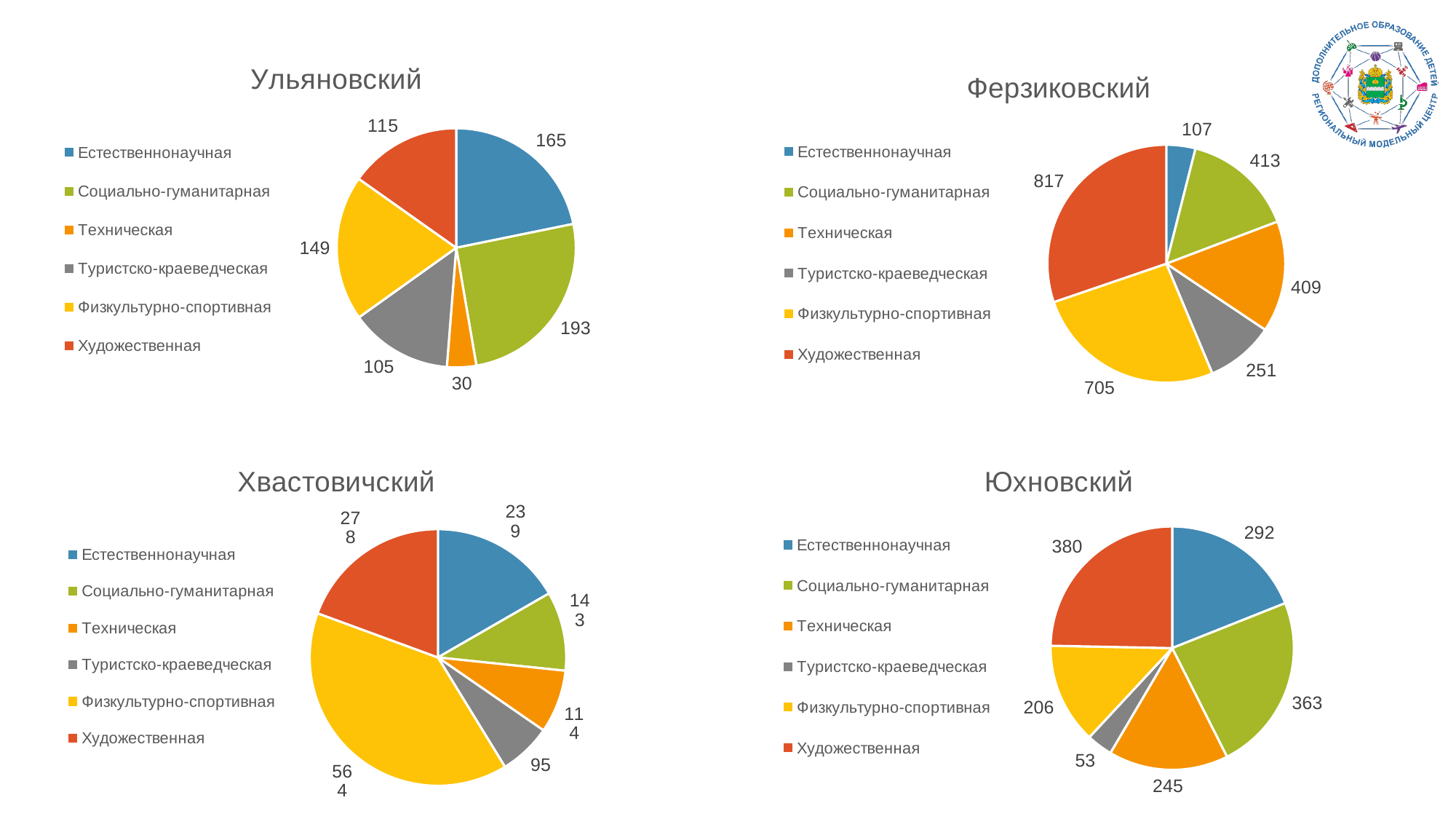
In the Ферзиковский chart, what is the value for Физкультурно-спортивная? 705 What type of chart is used for Ульяновский? Pie chart In the Юхновский chart, what is the value for Туристско-краеведческая? 53 In the Ферзиковский chart, which category has the largest value? Художественная In the Ульяновский chart, what is the value for Социально-гуманитарная? 193 In the Хвастовичский chart, which category has the largest slice? Физкультурно-спортивная In the Ферзиковский chart, what is the total of all slices? 2702 How many categories does the legend of the Хвастовичский chart list? 6 In the Юхновский chart, what is the difference between Художественная and Физкультурно-спортивная? 174 In the Ульяновский chart, what is the difference between Естественнонаучная and Художественная? 50 In the Юхновский chart, which is larger, Естественнонаучная or Социально-гуманитарная? Социально-гуманитарная In the Ульяновский chart, which category has the smallest value? Техническая